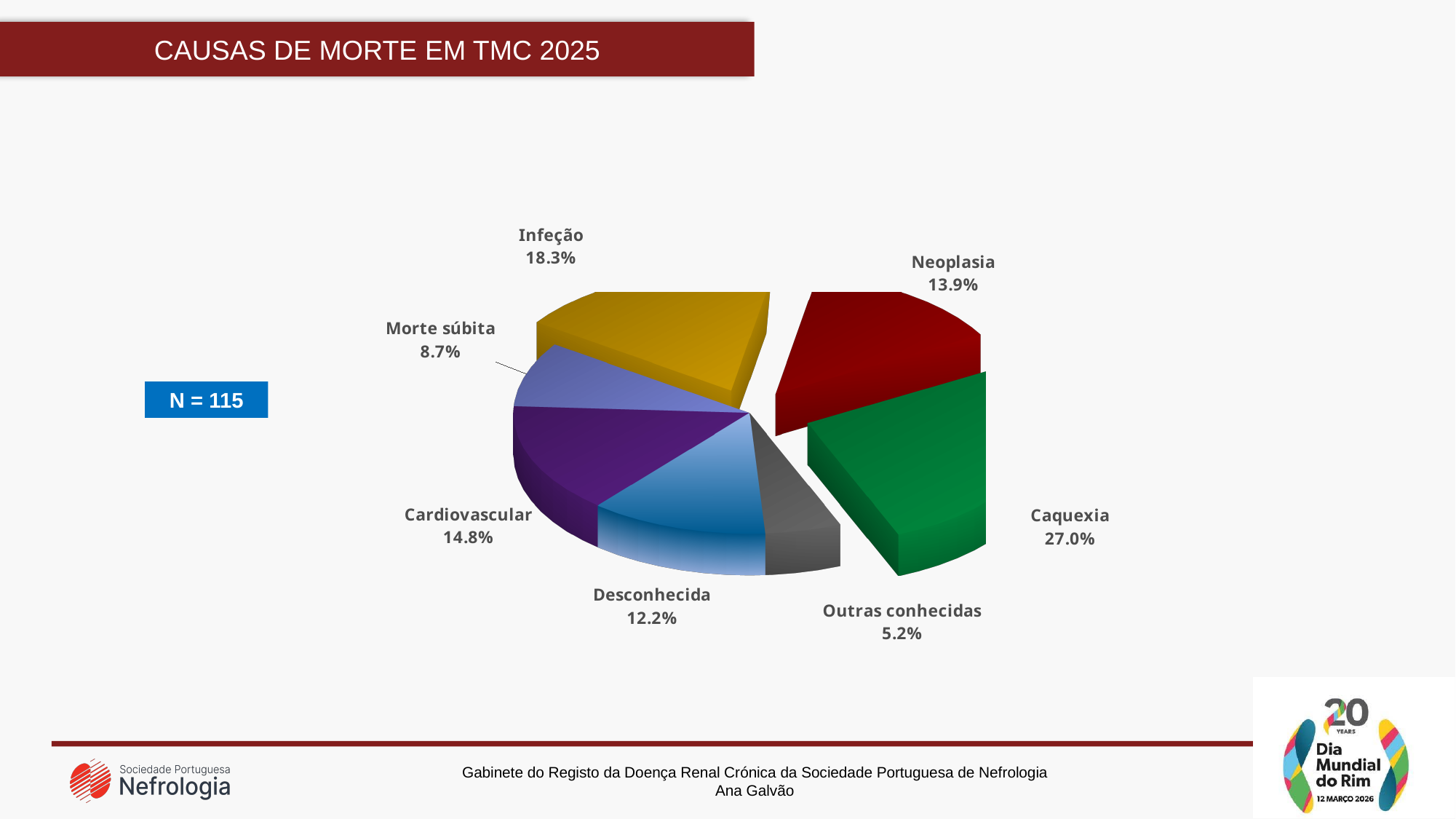
What is the difference in percentage points between Cardiovascular and Neoplasia? 0.9 Which cause of death has the smallest share of the pie? Outras conhecidas What percentage is shown for Infeção? 18.3% What percentage is shown for Desconhecida? 12.2% Which cause of death has the largest share of the pie? Caquexia What is the title of the chart? CAUSAS DE MORTE EM TMC 2025 What share of deaths is attributed to Caquexia? 27.0% Which has a larger share, Cardiovascular or Desconhecida? Cardiovascular How many categories are shown in the pie chart? 7 What is the value for Morte súbita? 8.7% What is the difference in percentage points between Caquexia and Infeção? 8.7 What kind of chart is shown on the slide? Pie chart